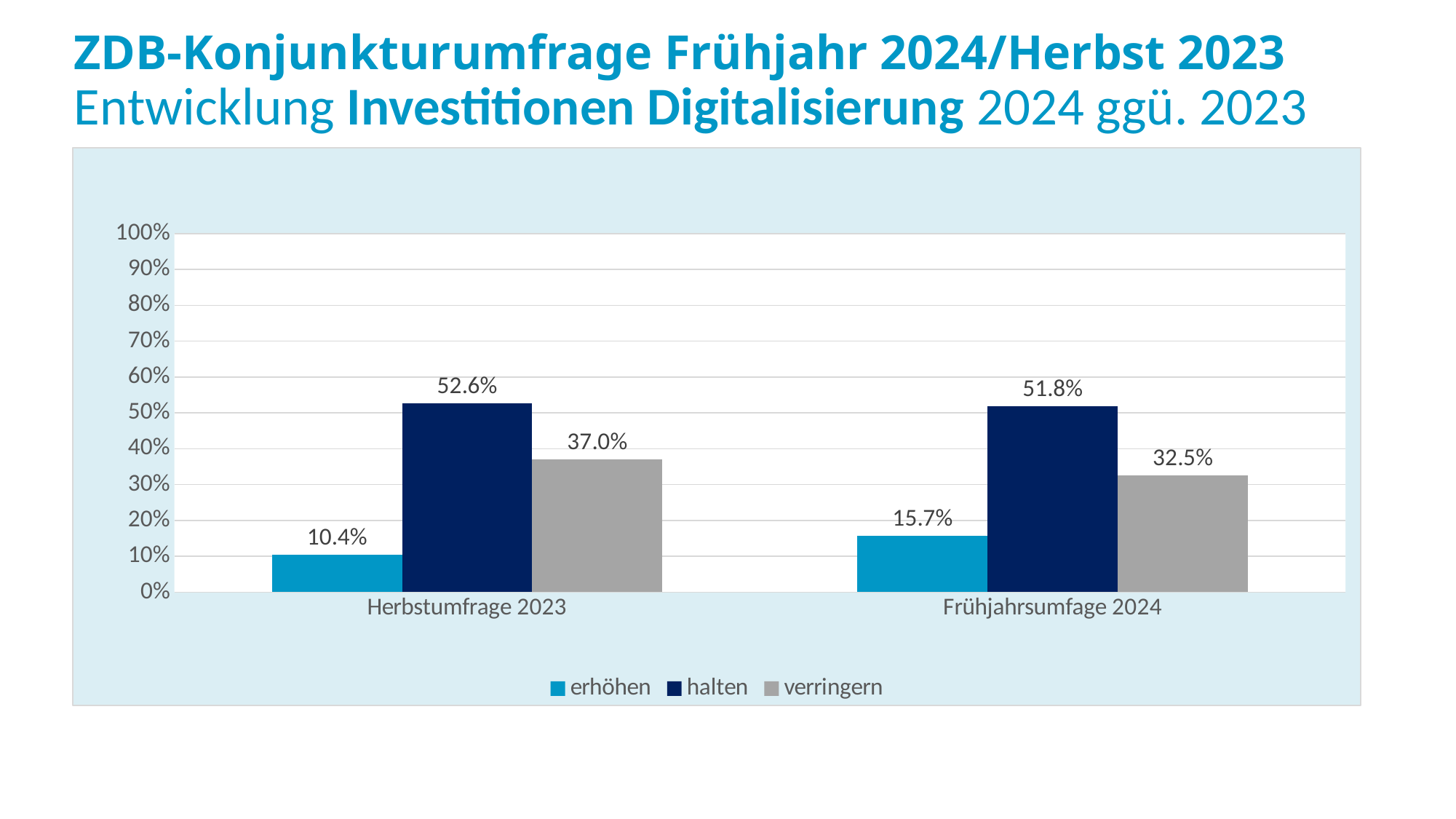
What is the value for "verringern" in Herbstumfrage 2023? 37.0% What is the value for "verringern" in Frühjahrsumfage 2024? 32.5% What is the difference between the "erhöhen" values for Frühjahrsumfage 2024 and Herbstumfrage 2023? 5.3% Which series has the highest value in Frühjahrsumfage 2024? halten How many categories are shown on the x axis? 2 How many series does the legend list? 3 What is the value for "erhöhen" in Frühjahrsumfage 2024? 15.7% Which is larger: "verringern" in Herbstumfrage 2023 or "verringern" in Frühjahrsumfage 2024? Herbstumfrage 2023 What kind of chart is shown on the slide? bar chart Which series has the lowest value in Herbstumfrage 2023? erhöhen Is the value for "halten" in Herbstumfrage 2023 greater or less than 50%? greater What is the value for "halten" in Herbstumfrage 2023? 52.6%